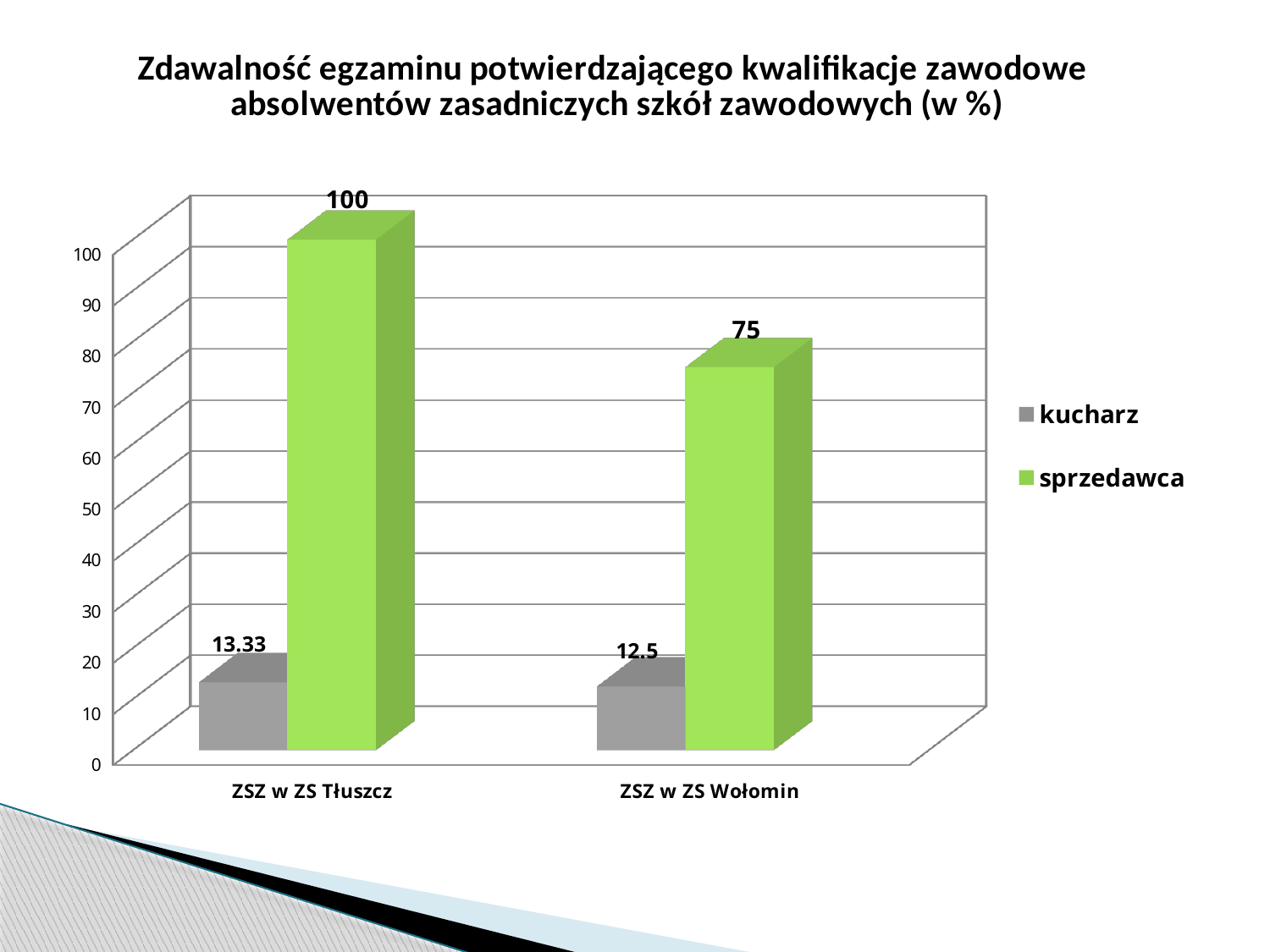
What is the value for sprzedawca at ZSZ w ZS Tłuszcz? 100 What is the value for kucharz at ZSZ w ZS Wołomin? 12.5 What is the difference between the sprzedawca and kucharz values at ZSZ w ZS Wołomin? 62.5 What is the difference between the sprzedawca values for ZSZ w ZS Tłuszcz and ZSZ w ZS Wołomin? 25 What kind of chart is shown on the slide? bar chart How many series does the legend list? 2 Which school has the higher value for sprzedawca? ZSZ w ZS Tłuszcz What is the value for sprzedawca at ZSZ w ZS Wołomin? 75 Which school has the lower value for kucharz? ZSZ w ZS Wołomin Is the value for kucharz at ZSZ w ZS Tłuszcz greater or less than 20? less How many schools are shown on the x axis? 2 What is the value for kucharz at ZSZ w ZS Tłuszcz? 13.33